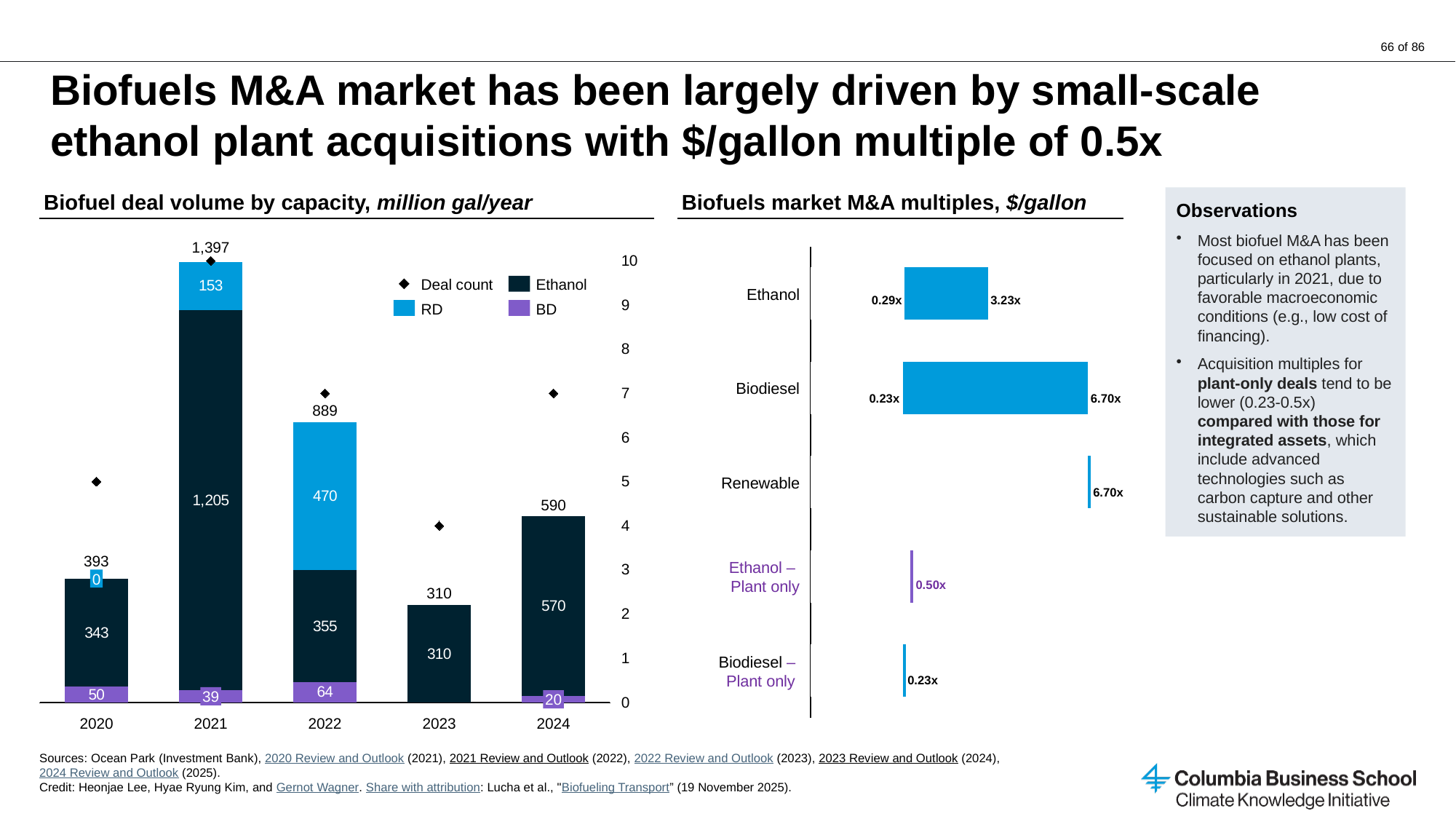
How many years are shown on the x axis of the 'Biofuel deal volume by capacity' chart? 5 In the 'Biofuel deal volume by capacity' chart, which year has the lowest total deal volume? 2023 In the 'Biofuels market M&A multiples' chart, what is the upper multiple shown for Ethanol? 3.23x In the 'Biofuel deal volume by capacity' chart, what is the Ethanol value for 2024? 570 In the 'Biofuel deal volume by capacity' chart, is the deal count for 2021 greater or less than 8? greater In the 'Biofuel deal volume by capacity' chart, what is the RD value for 2022? 470 In the 'Biofuel deal volume by capacity' chart, which year has the highest total deal volume? 2021 In the 'Biofuel deal volume by capacity' chart, what is the total deal volume labeled for 2021? 1,397 In the 'Biofuel deal volume by capacity' chart, what is the difference between the 2021 total (1,397) and the 2022 total (889)? 508 How many entries does the legend of the 'Biofuel deal volume by capacity' chart list? 4 In the 'Biofuels market M&A multiples' chart, what multiple is shown for Ethanol – Plant only? 0.50x In the 'Biofuel deal volume by capacity' chart, is the BD value larger in 2022 or in 2020? 2022